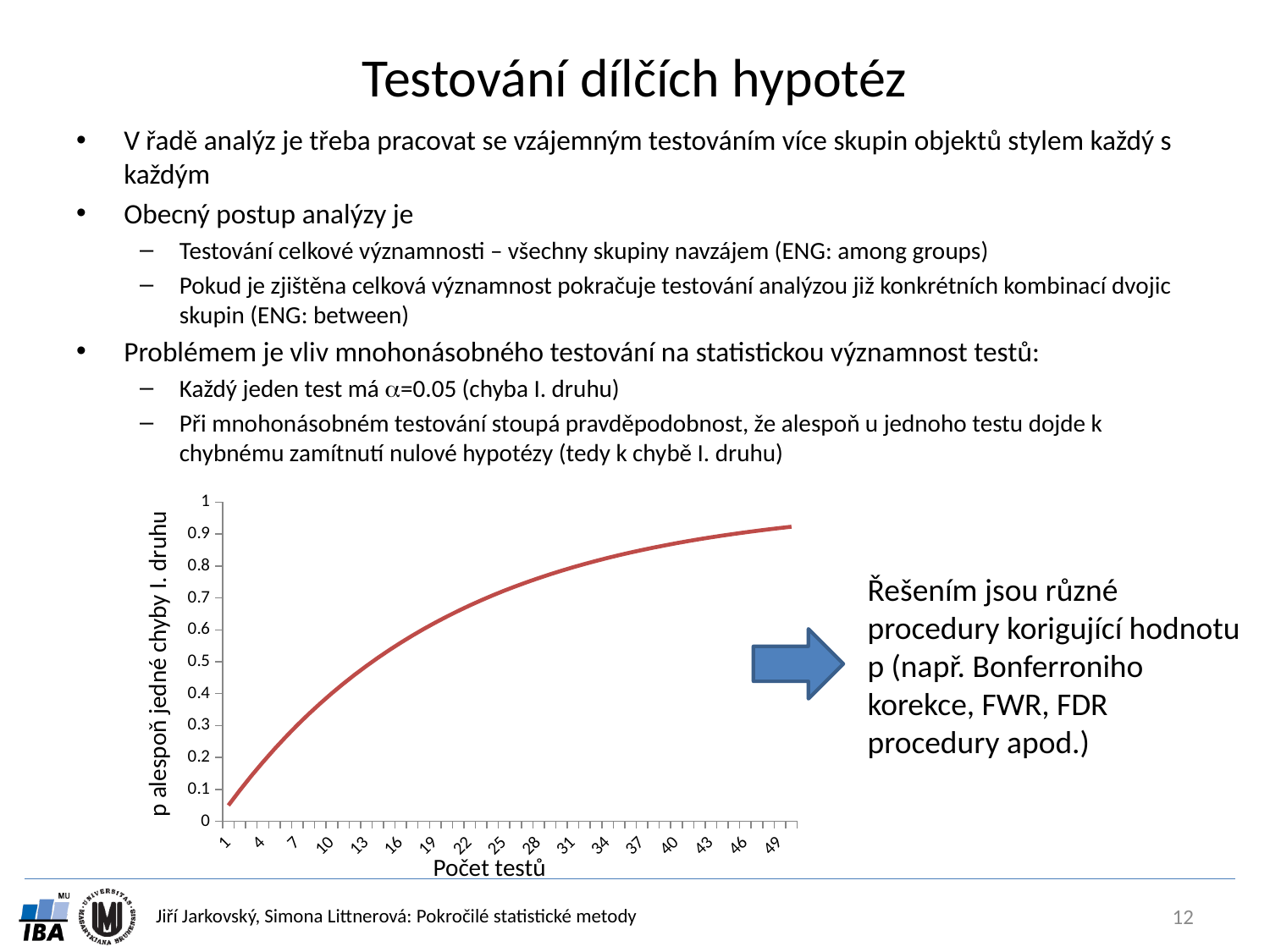
Do the values on the chart rise or fall as the number of tests (Počet testů) increases? rise At which number of tests is the plotted value lowest? 1 Which is larger, the value for 7 tests or the value for 40 tests? 40 tests Is the value for 4 tests greater or less than 0.5? less What is the label of the x axis of the chart? Počet testů How many lines are plotted on the chart? 1 Is the value for 10 tests greater or less than 0.3? greater Is the value for 49 tests greater or less than 0.8? greater What kind of chart is shown on the slide? line chart What is the label of the y axis of the chart? p alespoň jedné chyby I. druhu